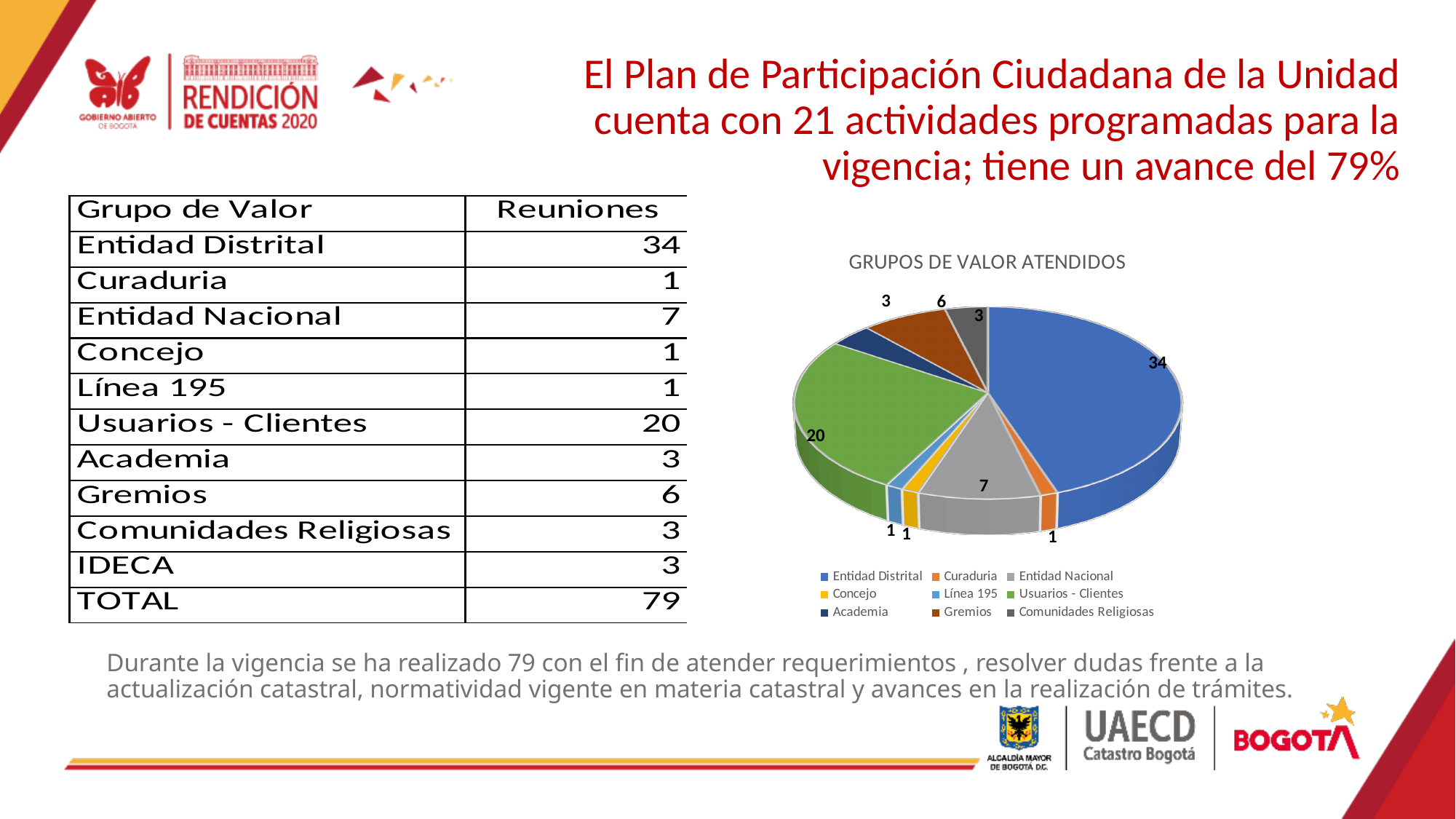
Which is larger in the pie chart, Gremios or Academia? Gremios Which category has the largest slice in the pie chart? Entidad Distrital How many slices does the pie chart have? 9 What colour is the Usuarios - Clientes slice in the pie chart? green How many categories does the legend of the pie chart list? 9 What is the title of the chart? GRUPOS DE VALOR ATENDIDOS What is the difference between the values for Entidad Distrital and Usuarios - Clientes? 14 What kind of chart is shown on the slide? pie chart What is the value for Entidad Nacional in the pie chart? 7 What is the value for Entidad Distrital in the pie chart? 34 What is the value for Gremios in the pie chart? 6 What is the value for Usuarios - Clientes in the pie chart? 20